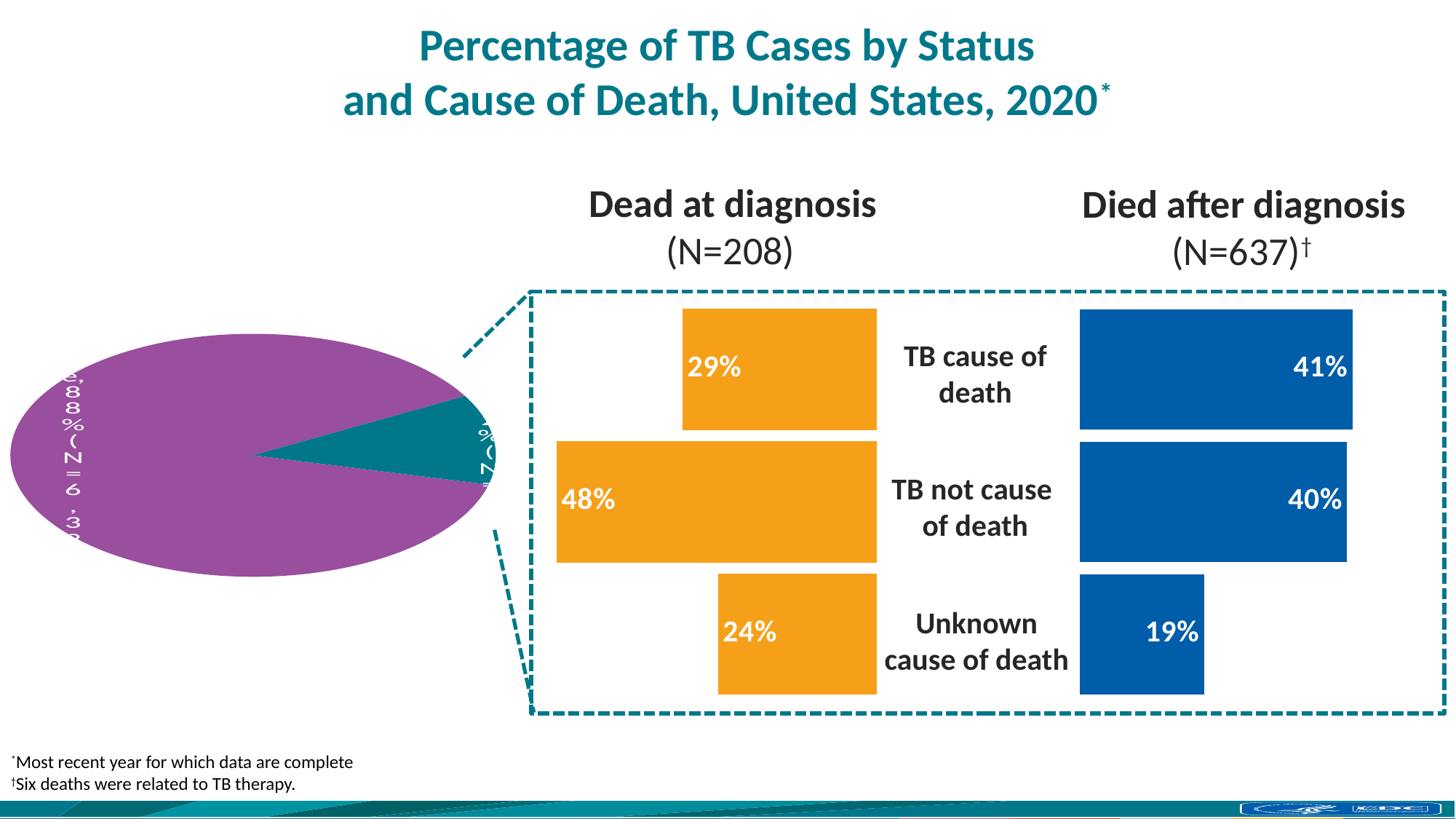
How many cause-of-death categories are shown in the Dead at diagnosis chart? 3 In the Dead at diagnosis chart, what percentage of cases had TB not as the cause of death? 48% In the Dead at diagnosis chart, which cause-of-death category has the highest percentage? TB not cause of death In the Died after diagnosis chart, which cause-of-death category has the lowest percentage? Unknown cause of death What kind of chart is shown on the left side of the slide? Pie chart In the Died after diagnosis chart, what is the difference between the TB cause of death and Unknown cause of death percentages? 22% What kind of chart is used for the Dead at diagnosis and Died after diagnosis data? Bar chart In the Died after diagnosis chart, what percentage of cases had TB as the cause of death? 41% Which is larger: the TB cause of death percentage in the Dead at diagnosis chart or in the Died after diagnosis chart? Died after diagnosis In the Dead at diagnosis chart, what is the difference between the TB not cause of death and Unknown cause of death percentages? 24% In the Dead at diagnosis chart, what percentage of cases had TB as the cause of death? 29% In the Died after diagnosis chart, what percentage of cases had an unknown cause of death? 19%